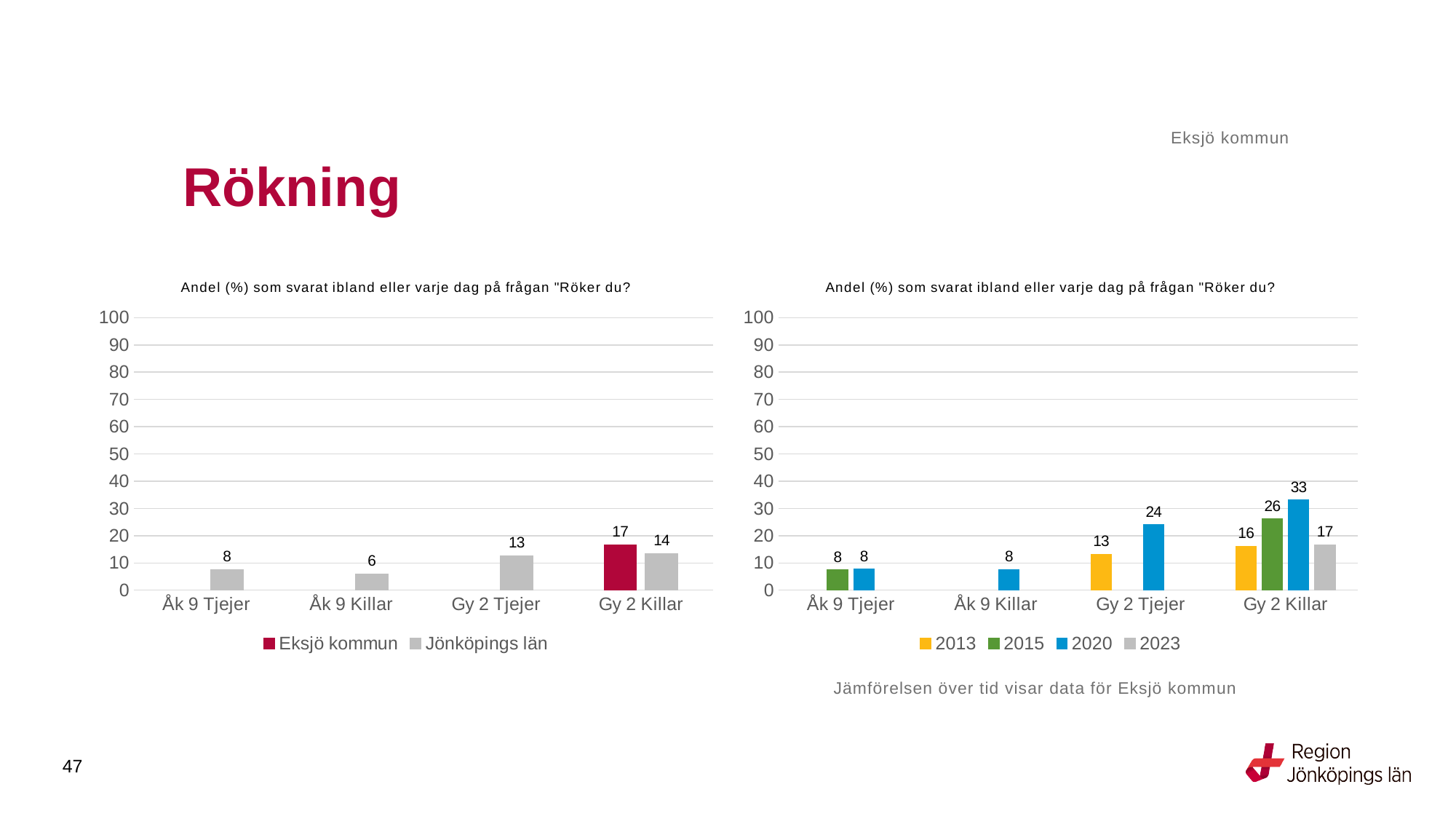
In the right chart, what is the difference between 2020 and 2013 for Gy 2 Tjejer? 11 In the left chart, what is the difference between Eksjö kommun and Jönköpings län for Gy 2 Killar? 3 In the right chart, what is the value for 2020 for Gy 2 Killar? 33 In the right chart, which is larger for Gy 2 Killar: the 2013 value or the 2023 value? 2023 In the right chart, which year has the highest value for Gy 2 Killar? 2020 In the left chart, which category has the lowest value for Jönköpings län? Åk 9 Killar What kind of chart is the left chart? bar chart In the right chart, what is the value for 2015 for Gy 2 Killar? 26 In the left chart, what is the value for Jönköpings län for Gy 2 Tjejer? 13 In the left chart, how many series does the legend list? 2 In the left chart, what is the value for Eksjö kommun for Gy 2 Killar? 17 In the right chart, how many series does the legend list? 4